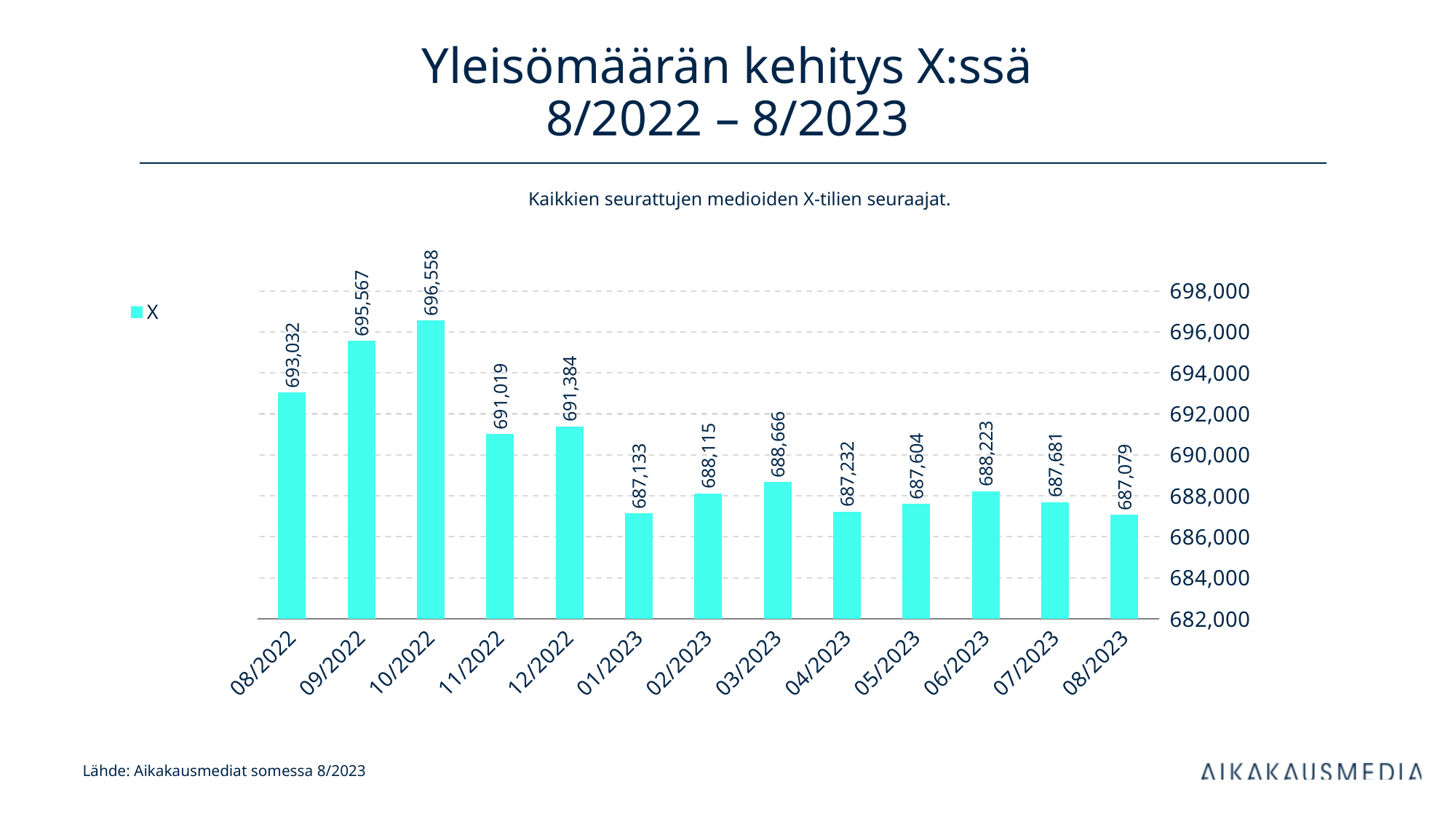
What is the value for 08/2023? 687,079 What is the difference between the values for 10/2022 and 08/2023? 9,479 What type of chart is shown on the slide? bar chart Which month has the lowest value? 08/2023 What is the name of the series shown in the legend? X Which month has the highest value? 10/2022 What is the value for 10/2022? 696,558 How many months are shown on the x axis? 13 What is the value for 01/2023? 687,133 Is the value for 12/2022 greater or less than 690,000? greater What is the difference between the values for 08/2022 and 08/2023? 5,953 Which is larger, the value for 09/2022 or the value for 11/2022? 09/2022